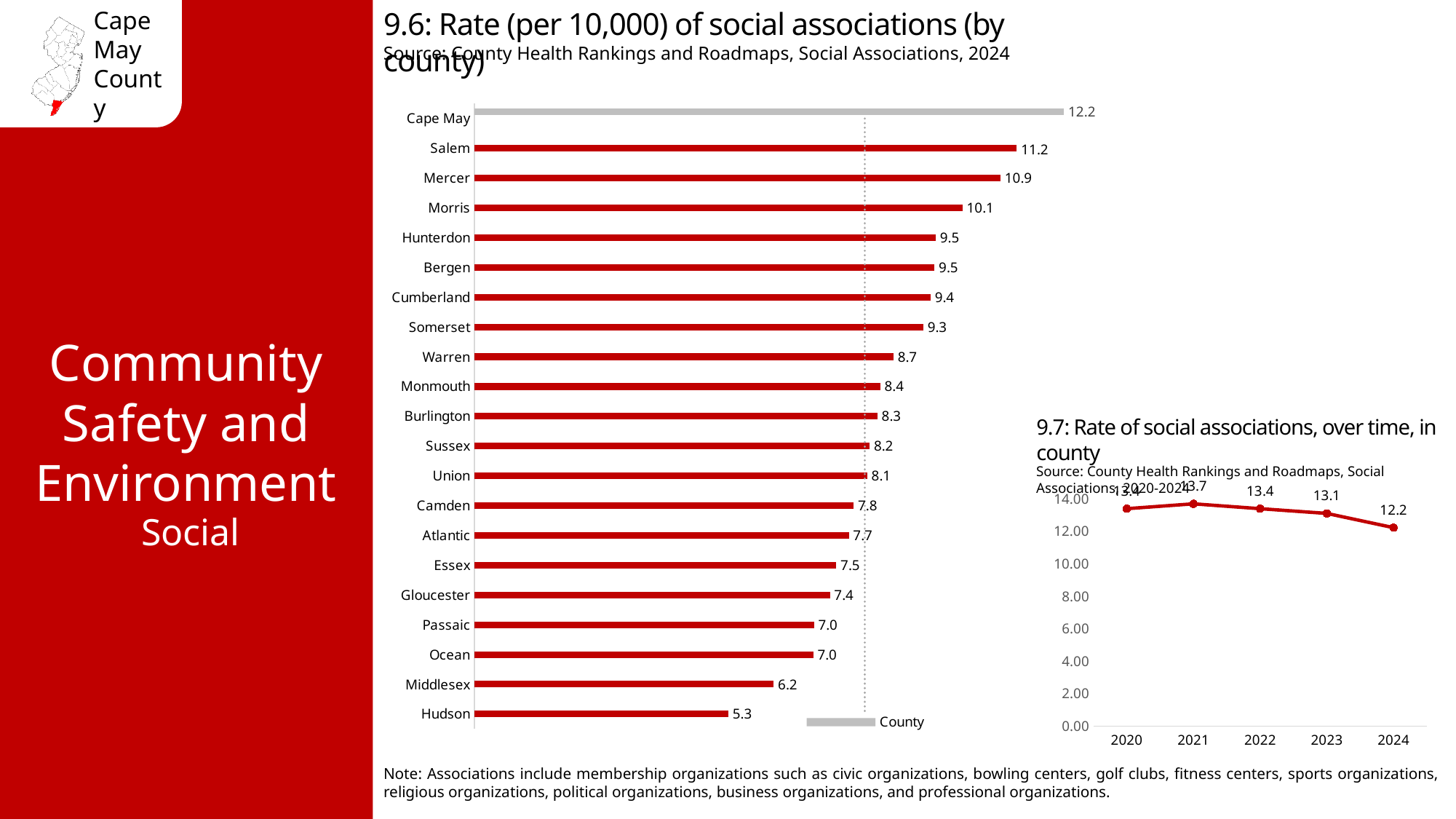
In chart 9.6 (rate of social associations by county), what is the value for Cape May? 12.2 In chart 9.7 (rate of social associations over time), what is the difference between the 2021 and 2024 values? 1.5 What kind of chart is chart 9.6 (rate of social associations by county)? Bar chart In chart 9.7 (rate of social associations over time), what is the value for 2021? 13.7 In chart 9.6 (rate of social associations by county), which county has the lowest rate? Hudson In chart 9.6 (rate of social associations by county), how many counties are shown? 21 In chart 9.6 (rate of social associations by county), which county has the highest rate? Cape May In chart 9.7 (rate of social associations over time), which year has the lowest value? 2024 In chart 9.6 (rate of social associations by county), what is the difference between the values for Salem and Hudson? 5.9 In chart 9.7 (rate of social associations over time), how many years are plotted? 5 In chart 9.6 (rate of social associations by county), what is the value for Mercer? 10.9 In chart 9.6 (rate of social associations by county), which has a higher value, Morris or Warren? Morris